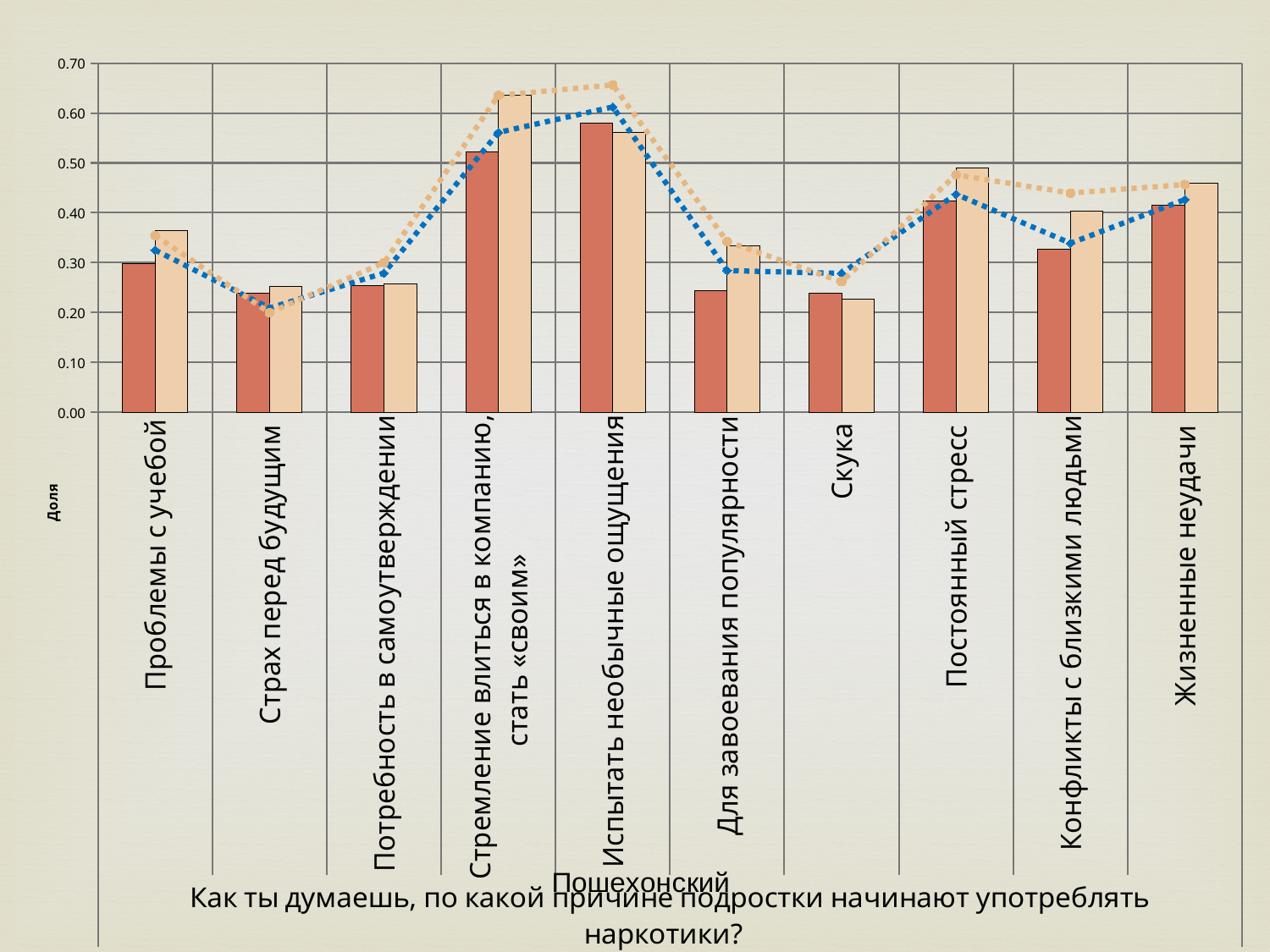
What question is given as the chart title at the bottom of the slide? Как ты думаешь, по какой причине подростки начинают употреблять наркотики? For «Постоянный стресс», which bar is taller: the dark red bar or the light beige bar? the light beige bar Is the dark red bar for «Скука» greater or less than 0.30? less What is the label on the vertical axis? Доля Among the dark red bars, which category has the highest value? Испытать необычные ощущения Is the light beige bar for «Стремление влиться в компанию, стать «своим»» greater or less than 0.60? greater Is the dark red bar for «Стремление влиться в компанию, стать «своим»» greater or less than 0.50? greater How many categories (reasons) are shown along the x axis? 10 What kind of chart is shown on the slide? bar chart combined with line series Among the dark red bars, which is larger: «Стремление влиться в компанию, стать «своим»» or «Постоянный стресс»? Стремление влиться в компанию, стать «своим» Among the light beige bars, which category has the highest value? Стремление влиться в компанию, стать «своим»